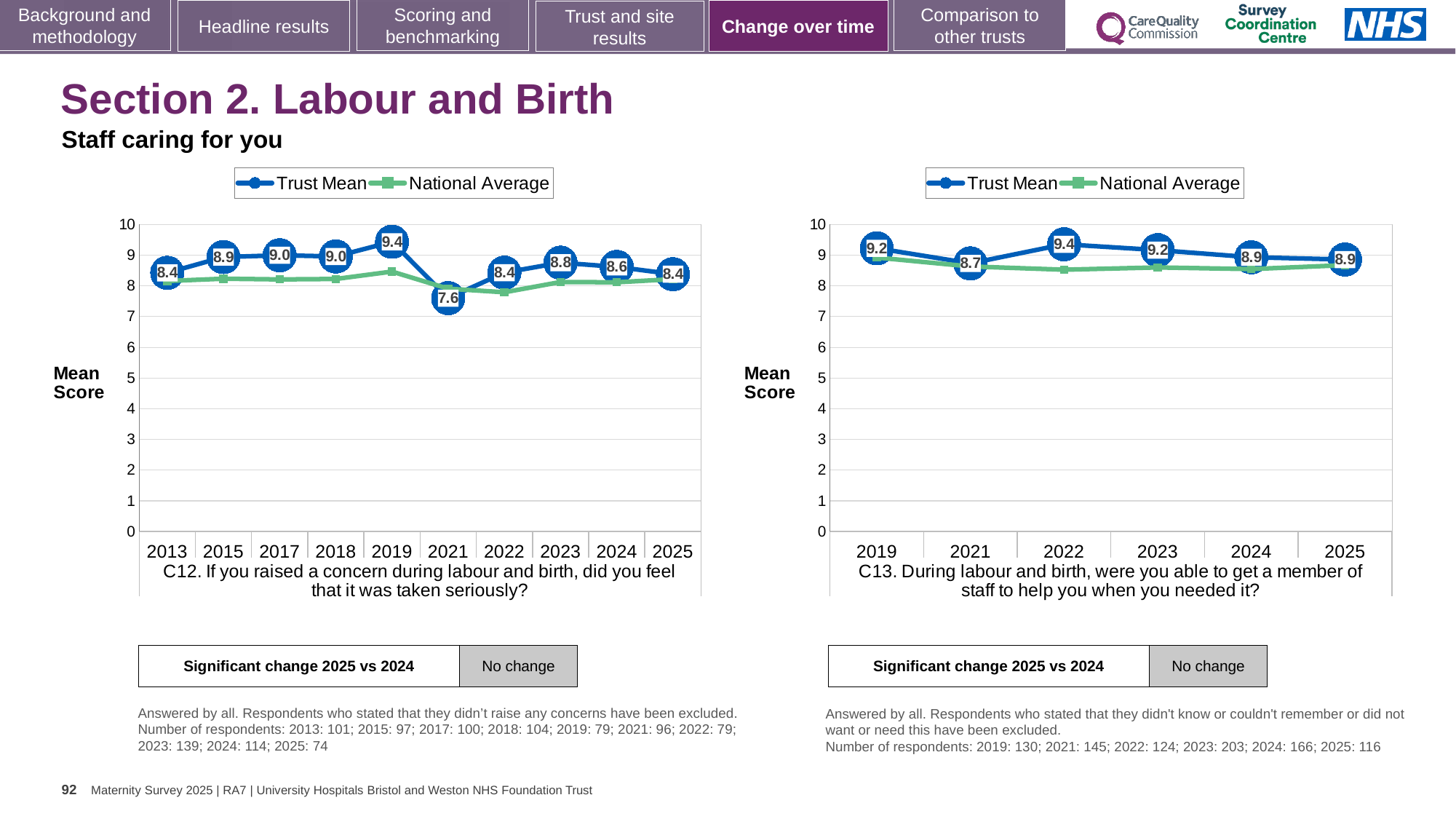
In the C12 chart on the left, how many years are shown on the x axis? 10 In the C13 chart on the right, is the National Average for 2022 greater or less than 8? greater In the C13 chart on the right, which year has the lowest Trust Mean? 2021 How many series does the legend of the C13 chart on the right list? 2 In the C12 chart on the left, what is the Trust Mean for 2021? 7.6 In the C12 chart on the left, what is the Trust Mean for 2019? 9.4 In the C12 chart on the left, which year has the highest Trust Mean? 2019 In the C13 chart on the right, is the Trust Mean for 2019 or 2021 larger? 2019 In the C12 chart on the left, what is the difference between the Trust Mean for 2019 and 2021? 1.8 In the C13 chart on the right, what is the Trust Mean for 2025? 8.9 In the C12 chart on the left, which year has the lowest Trust Mean? 2021 In the C13 chart on the right, what is the Trust Mean for 2022? 9.4